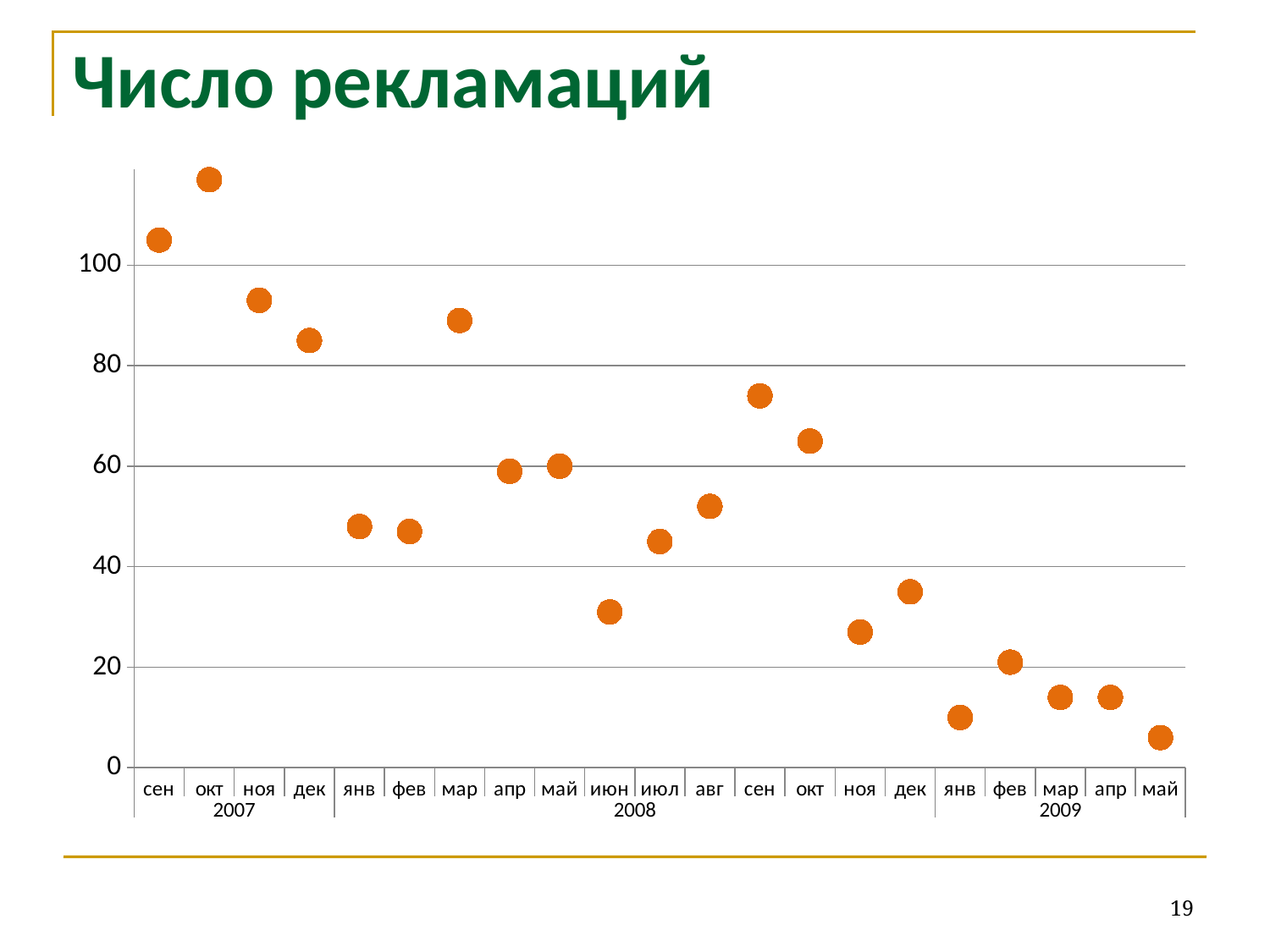
Which month has the lowest number of complaints? май 2009 Which month has the highest number of complaints? окт 2007 Is the value for мар 2008 greater or less than 80? greater How many data points are plotted on the chart? 21 What is the title of the chart? Число рекламаций Is the value for окт 2007 greater or less than 100? greater Which is larger, the value for сен 2007 or the value for дек 2007? сен 2007 Which is larger, the value for июн 2008 or the value for мар 2008? мар 2008 Overall, do the values rise or fall from сен 2007 to май 2009? fall Is the value for сен 2008 greater or less than 60? greater